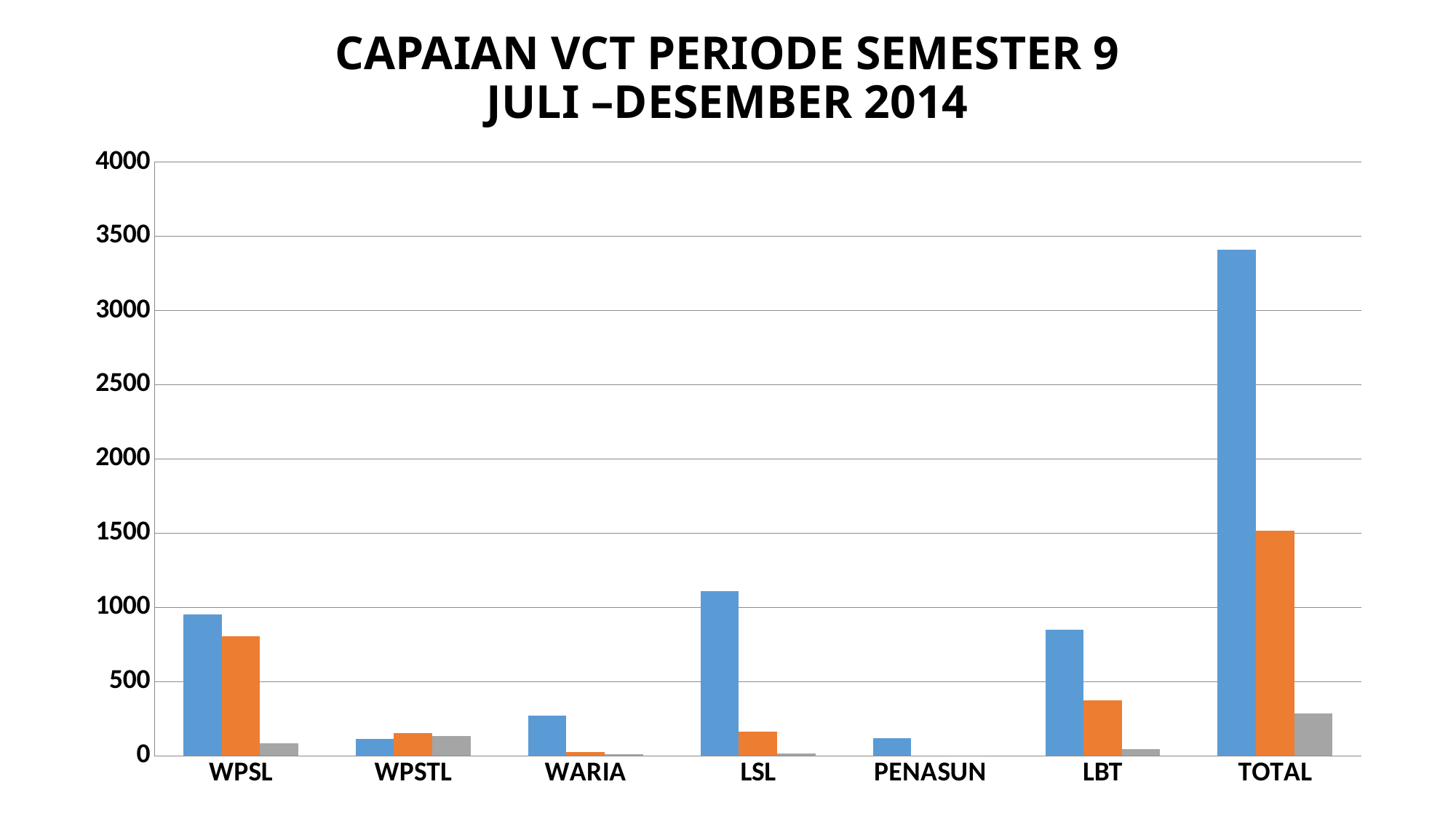
Excluding TOTAL, which category has the tallest blue bar? LSL What is the title of the chart? CAPAIAN VCT PERIODE SEMESTER 9 JULI –DESEMBER 2014 What kind of chart is shown on the slide? bar chart Which category has the tallest blue bar? TOTAL How many categories are shown along the x axis? 7 Is the blue bar for TOTAL greater or less than 3000? greater How many bars are shown for the WPSL category? 3 Which category has the tallest orange bar? TOTAL Is the blue bar for LSL greater or less than 1000? greater Which is larger, the orange bar for WPSL or the orange bar for LBT? WPSL Is the blue bar for WARIA greater or less than 500? less